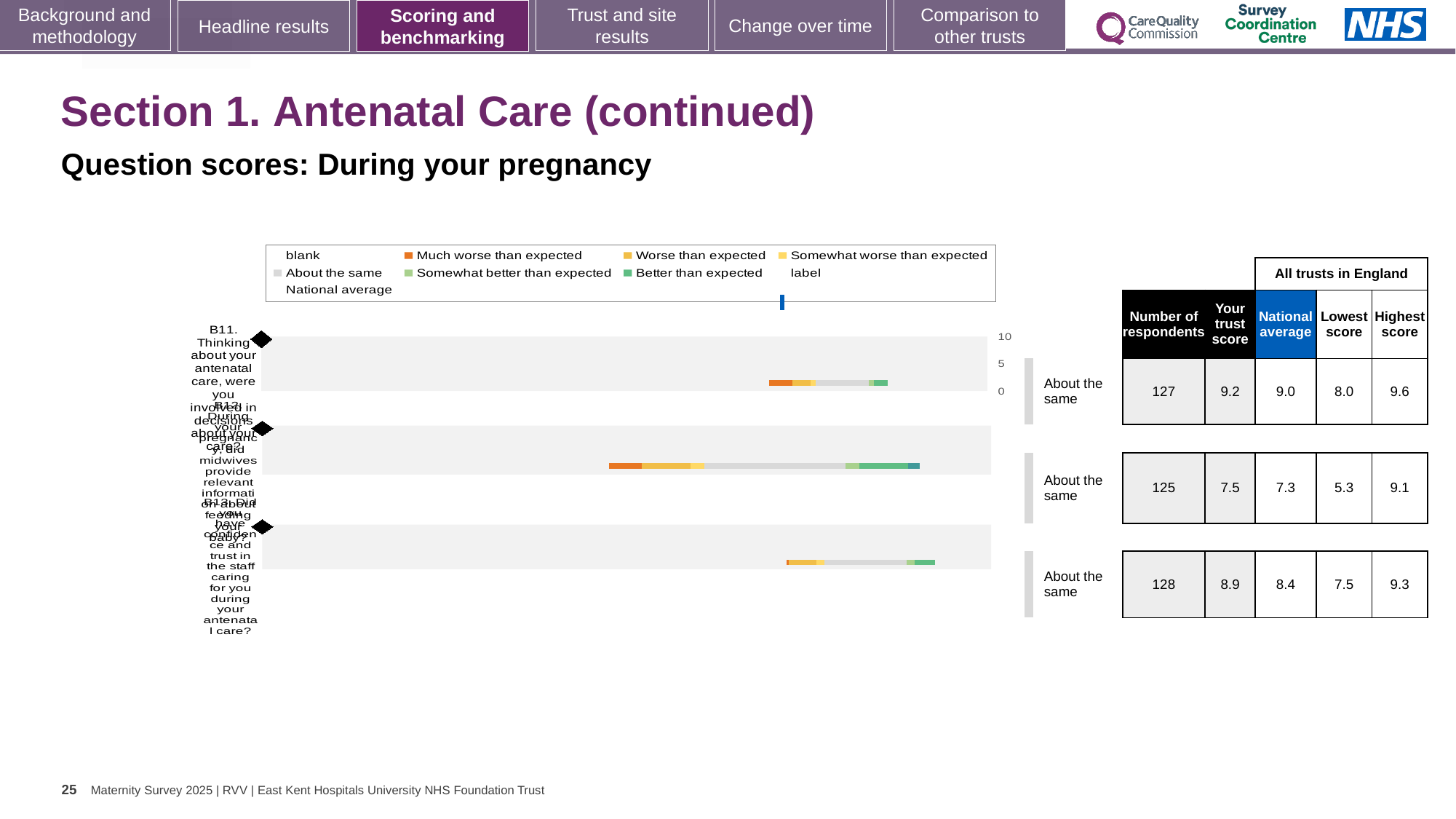
What kind of chart is shown on the slide? bar chart What colour represents 'About the same' in the chart legend? grey In the table next to the chart, what is the number of respondents for question B11? 127 What is the difference between the trust score and the national average for question B13? 0.5 In the table next to the chart, what is the lowest score across all trusts in England for question B12? 5.3 For question B11, is the trust score larger or smaller than the national average? larger In the table next to the chart, what is the trust score for question B12? 7.5 How many questions (categories) are plotted in the chart? 3 What colour represents 'Much worse than expected' in the chart legend? orange In the table next to the chart, what is the national average for question B13? 8.4 How many entries does the chart legend list? 9 Which of the three questions has the highest trust score in the table? B11